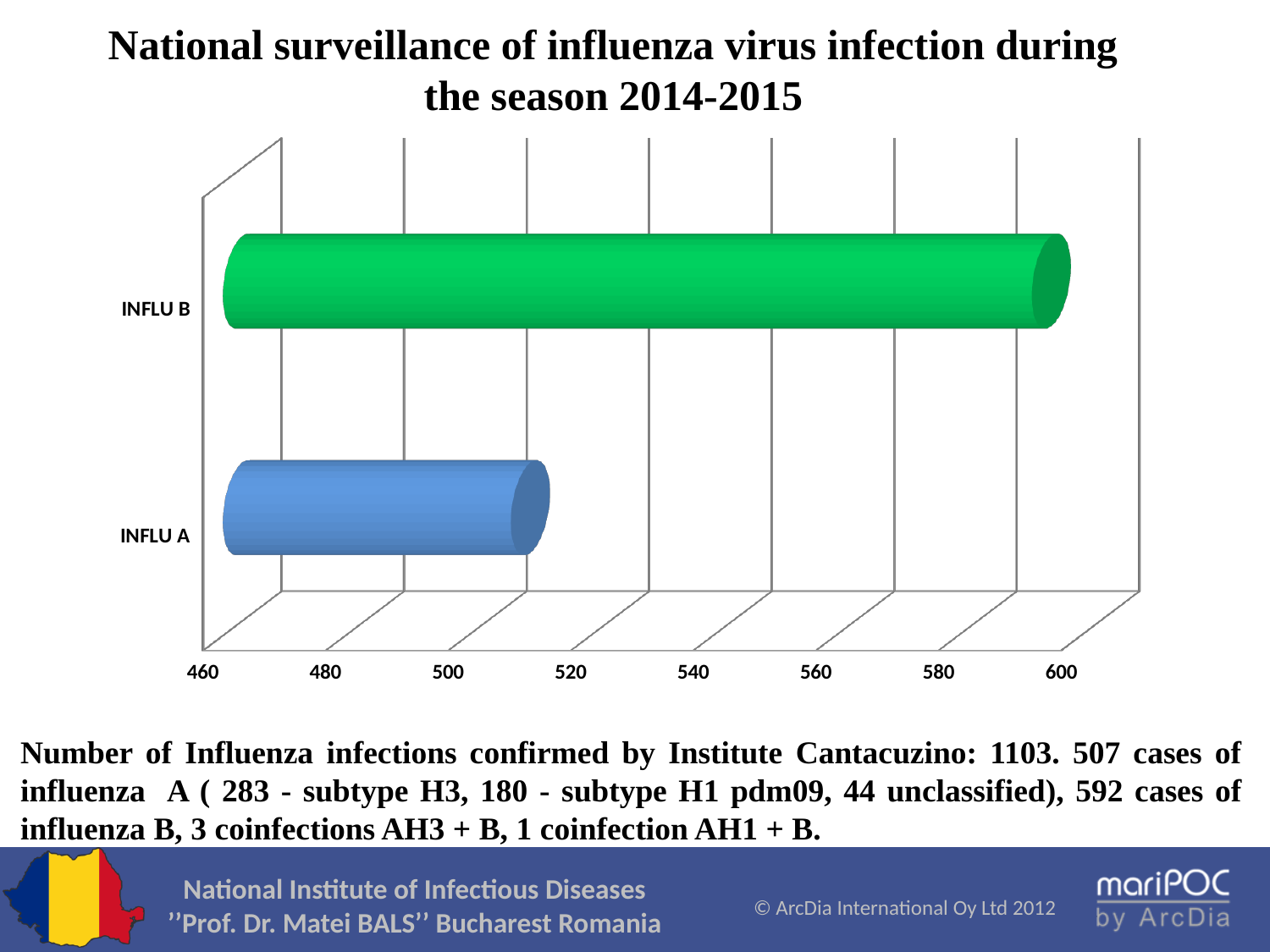
What is the highest tick value shown on the horizontal axis? 600 What kind of chart is shown on the slide? bar chart Is the value for INFLU B greater or less than 560? greater Is the value for INFLU A greater or less than 540? less Is the value for INFLU A greater or less than 500? greater How many categories are plotted in the chart? 2 Which is larger, the value for INFLU A or the value for INFLU B? INFLU B What is the title of the slide containing the chart? National surveillance of influenza virus infection during the season 2014-2015 What colour is the bar for INFLU B? green Which category has the lowest value in the chart? INFLU A Which category has the highest value in the chart? INFLU B